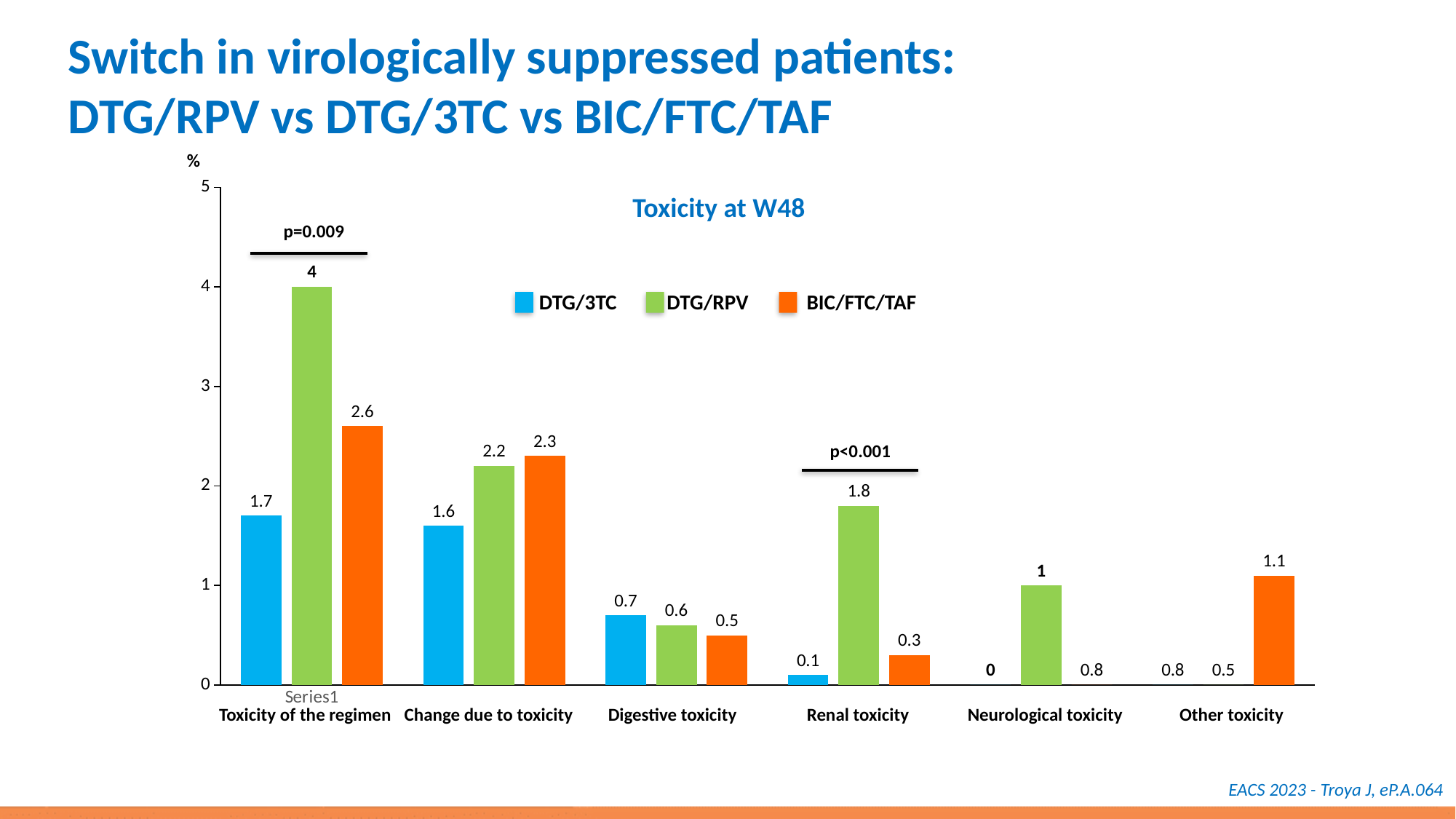
What kind of chart is shown on the slide? Bar chart What is the value for DTG/RPV in the Toxicity of the regimen category? 4 How many series does the legend list? 3 Which regimen has the lowest value in the Digestive toxicity category? BIC/FTC/TAF How many toxicity categories are shown on the x axis? 6 What is the value for DTG/RPV in the Renal toxicity category? 1.8 Which regimen has the highest value in the Toxicity of the regimen category? DTG/RPV What is the value for BIC/FTC/TAF in the Change due to toxicity category? 2.3 What is the difference between the DTG/RPV and DTG/3TC values in the Toxicity of the regimen category? 2.3 What is the value for DTG/3TC in the Renal toxicity category? 0.1 What p-value is shown above the Renal toxicity bars? p<0.001 Which is larger in the Renal toxicity category: the DTG/RPV value or the BIC/FTC/TAF value? DTG/RPV